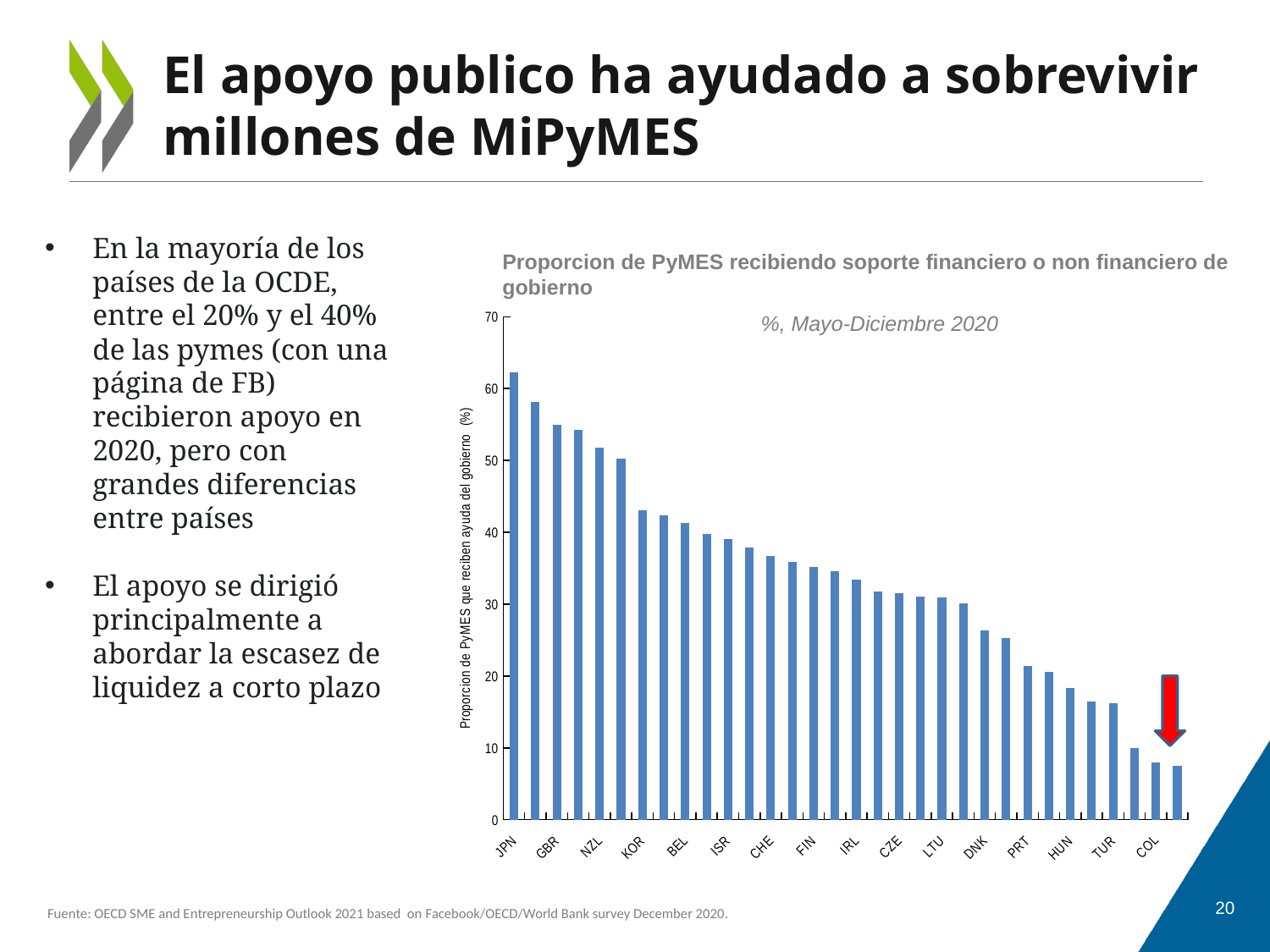
What kind of chart is shown on the slide? bar chart Which country has the highest proportion of SMEs receiving government support? JPN Is the value for CHE greater or less than 40? less Is the value for GBR greater or less than 50? greater What period does the chart subtitle say the data covers? Mayo-Diciembre 2020 Which has a larger value, TUR or IRL? IRL Is the value for DNK greater or less than 30? less Do the values rise or fall moving from left to right along the x axis? fall Which has a larger value, GBR or KOR? GBR